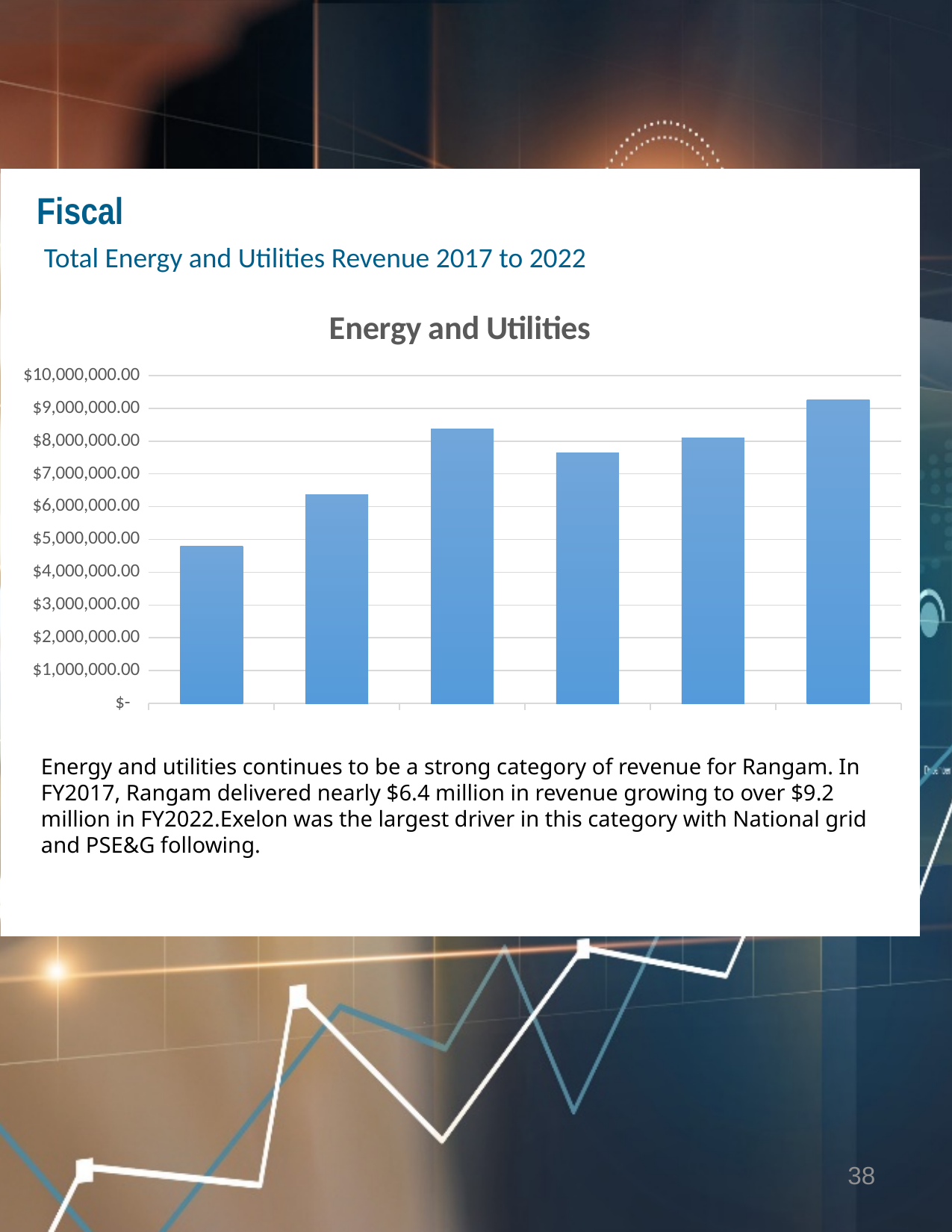
Which is larger, the third bar or the fourth bar? the third bar Is the last bar higher or lower than the first bar? higher What kind of chart is shown on the slide? bar chart Which bar is the shortest in the chart? the first (leftmost) bar Is the value of the sixth (rightmost) bar greater or less than $9,000,000.00? greater How many bars are plotted in the chart? 6 Which bar is the tallest in the chart? the sixth (rightmost) bar Is the value of the fourth bar greater or less than $8,000,000.00? less Is the value of the first (leftmost) bar greater or less than $5,000,000.00? less What is the title of the chart? Energy and Utilities What is the highest value shown on the chart's vertical axis? $10,000,000.00